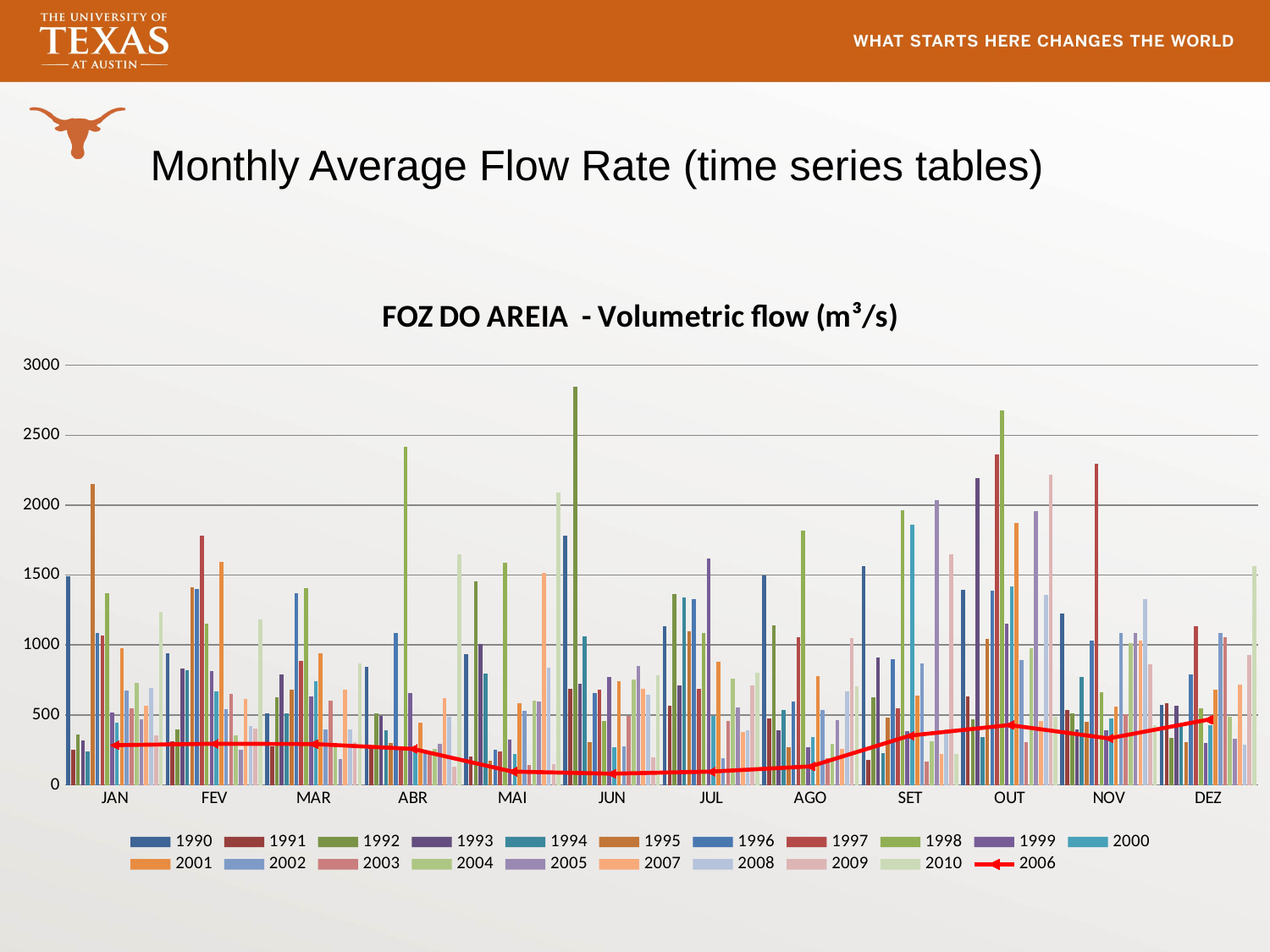
How many series does the legend list? 21 How many month categories are shown on the x axis? 12 Is the tallest bar in ABR greater or less than 2000? greater Does the 2006 line rise or fall from JAN to JUN? fall Is the 2006 line value for JAN greater or less than 1000? less Which is larger for the 2006 line, the value for JUN or the value for DEZ? DEZ Is the tallest bar in JUN greater or less than 2500? greater What kind of chart is shown on the slide? combination bar and line chart What is the title of the chart? FOZ DO AREIA - Volumetric flow (m³/s) Which year is drawn as a red line rather than bars? 2006